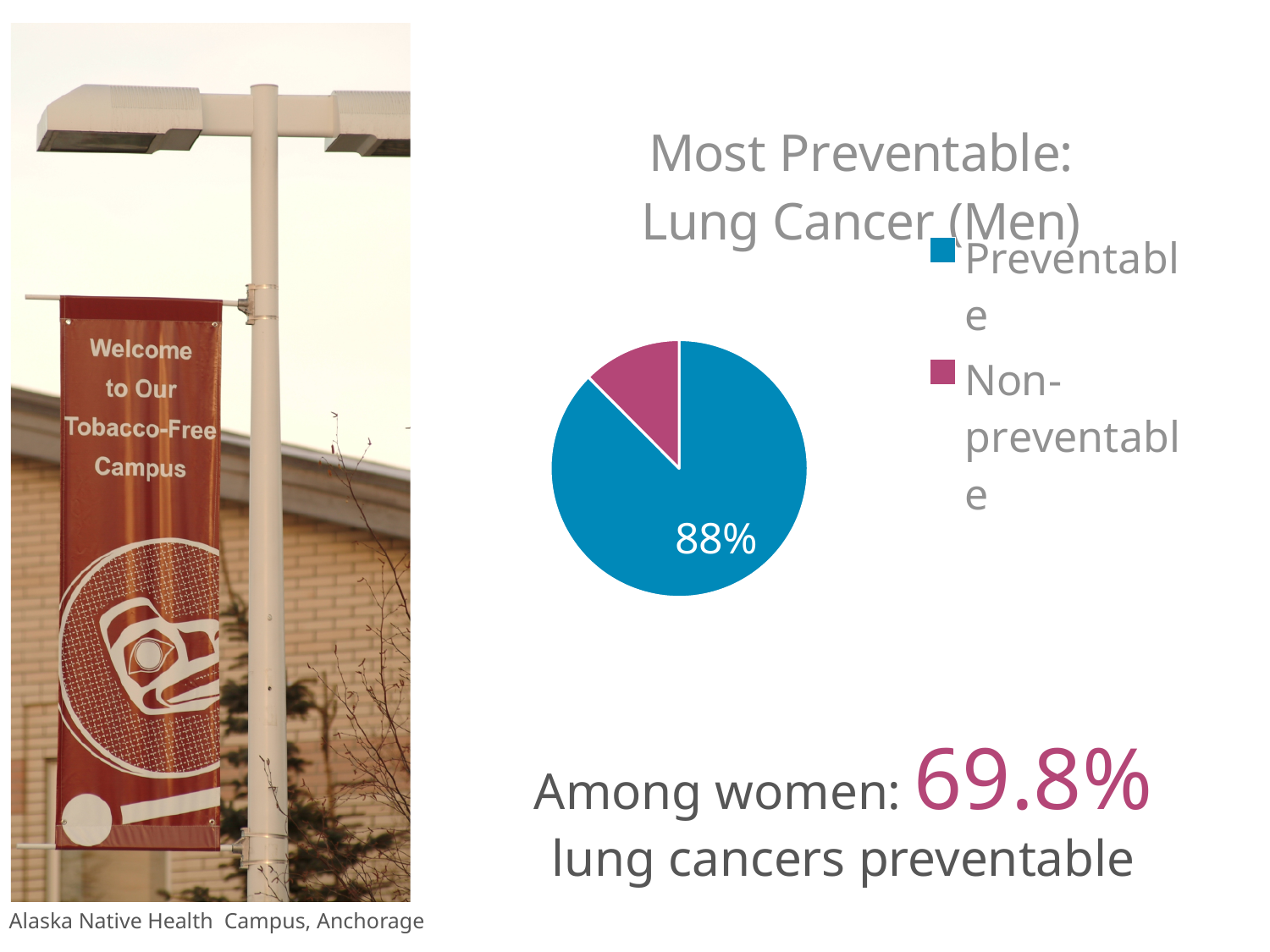
What is the title of the pie chart? Most Preventable: Lung Cancer (Men) What percentage does the Preventable slice of the pie chart show? 88% Which slice of the pie chart is the smallest? Non-preventable Which is larger in the pie chart, Preventable or Non-preventable? Preventable How many slices does the pie chart have? 2 What colour is the Preventable slice of the pie chart? Blue What kind of chart is shown on the slide? Pie chart Which slice of the pie chart is the largest? Preventable How many entries does the pie chart's legend list? 2